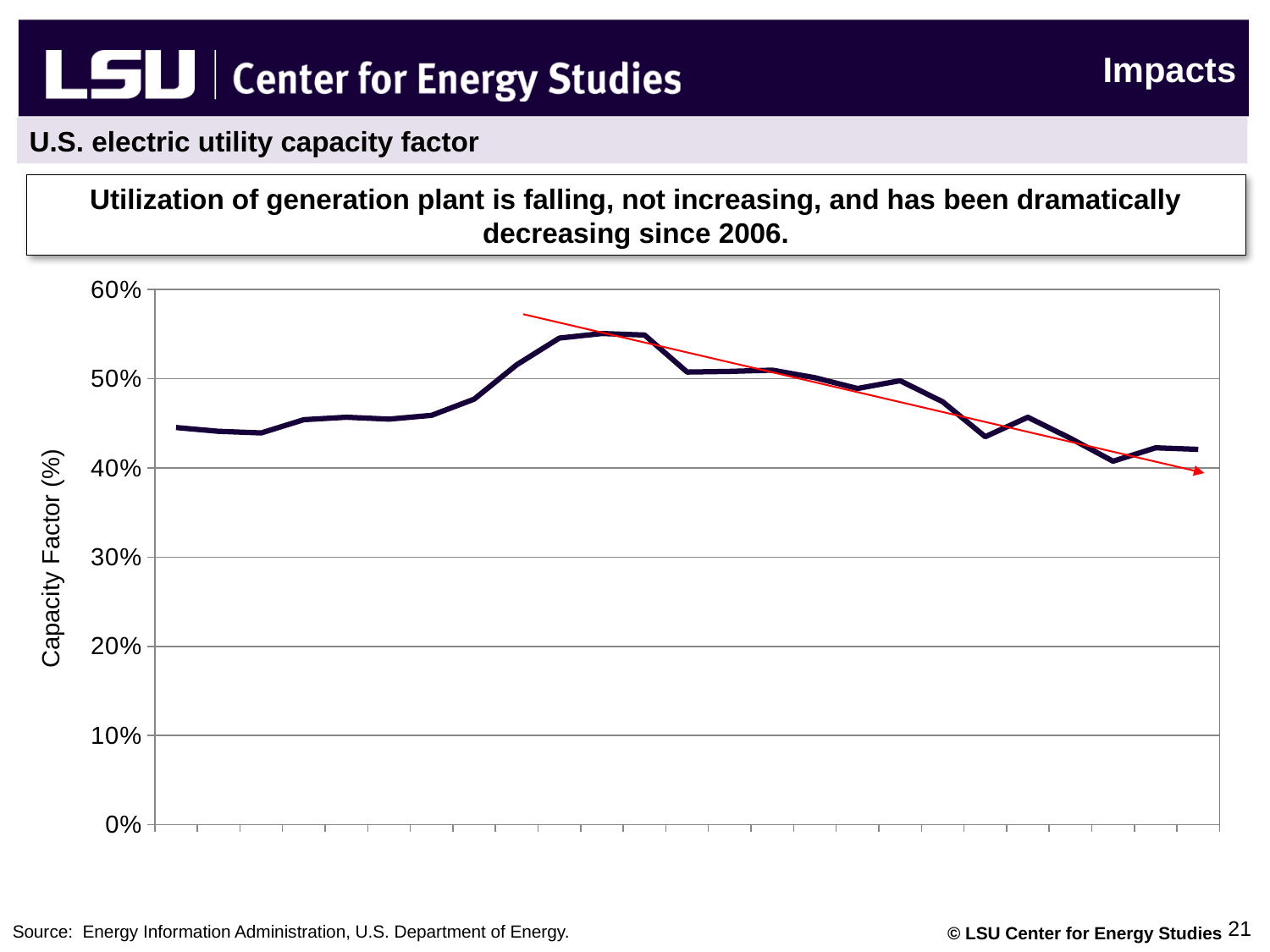
Is the highest point on the line greater or less than 60%? less What kind of chart is shown on the slide? line chart What is the label on the vertical axis of the chart? Capacity Factor (%) Is the lowest point on the line greater or less than 50%? less What is the title of the chart on the slide? U.S. electric utility capacity factor After reaching its peak, does the line generally rise or fall toward the right end of the chart? fall Is the last point on the right of the line greater or less than 50%? less What is the highest value shown on the vertical axis? 60% Is the last point on the right of the line higher or lower than the peak of the line? lower